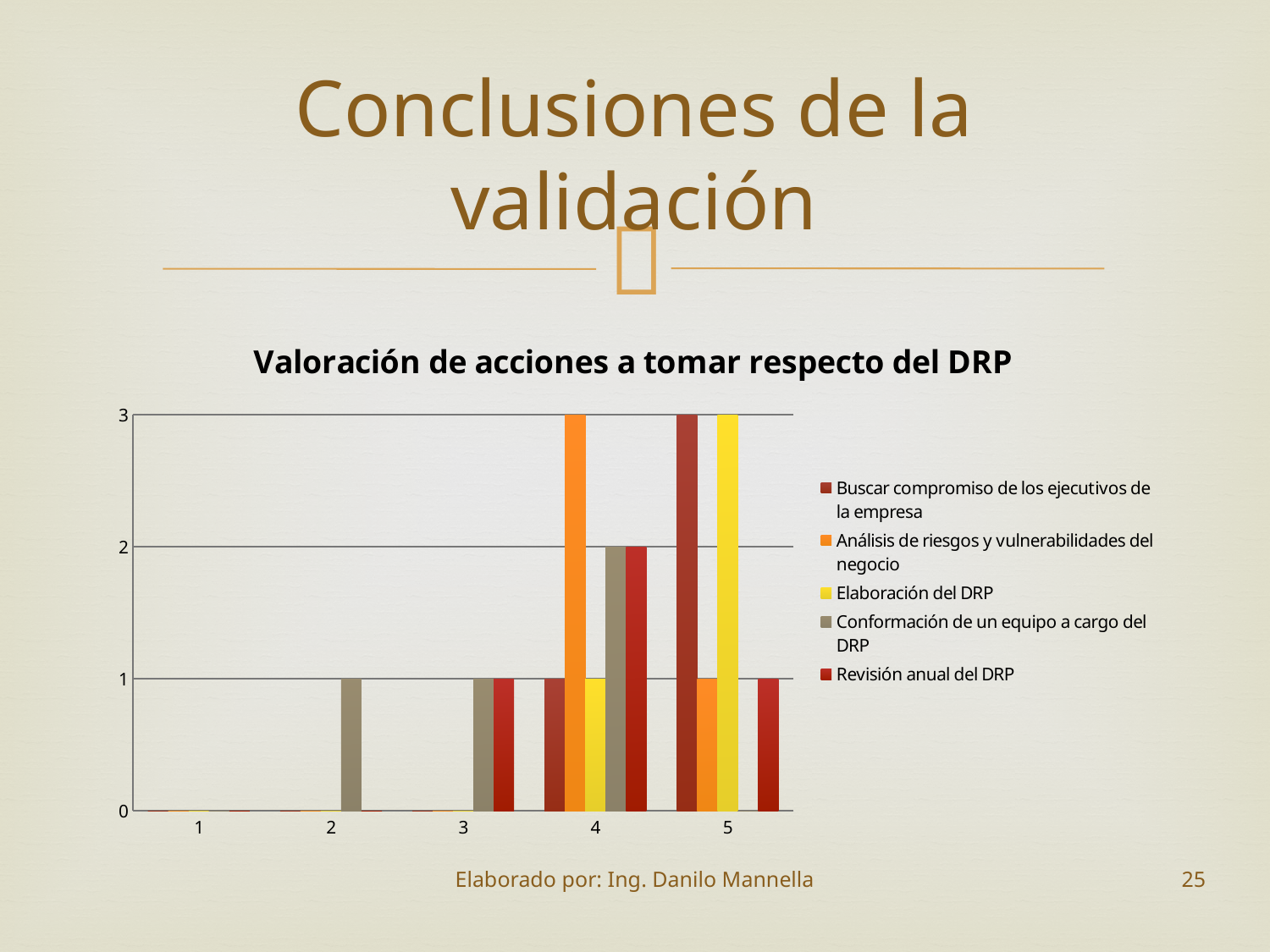
What is the title of the chart? Valoración de acciones a tomar respecto del DRP What is the value of 'Análisis de riesgos y vulnerabilidades del negocio' for category 4? 3 What is the difference between 'Análisis de riesgos y vulnerabilidades del negocio' for category 4 and for category 5? 2 What is the value of 'Buscar compromiso de los ejecutivos de la empresa' for category 5? 3 How many series does the legend list? 5 What is the value of 'Revisión anual del DRP' for category 3? 1 What kind of chart is shown on the slide? bar chart How many categories are shown on the x axis? 5 Which is larger for category 4: 'Análisis de riesgos y vulnerabilidades del negocio' or 'Elaboración del DRP'? Análisis de riesgos y vulnerabilidades del negocio What is the value of 'Elaboración del DRP' for category 5? 3 What is the value of 'Conformación de un equipo a cargo del DRP' for category 4? 2 For which category is 'Conformación de un equipo a cargo del DRP' highest? 4